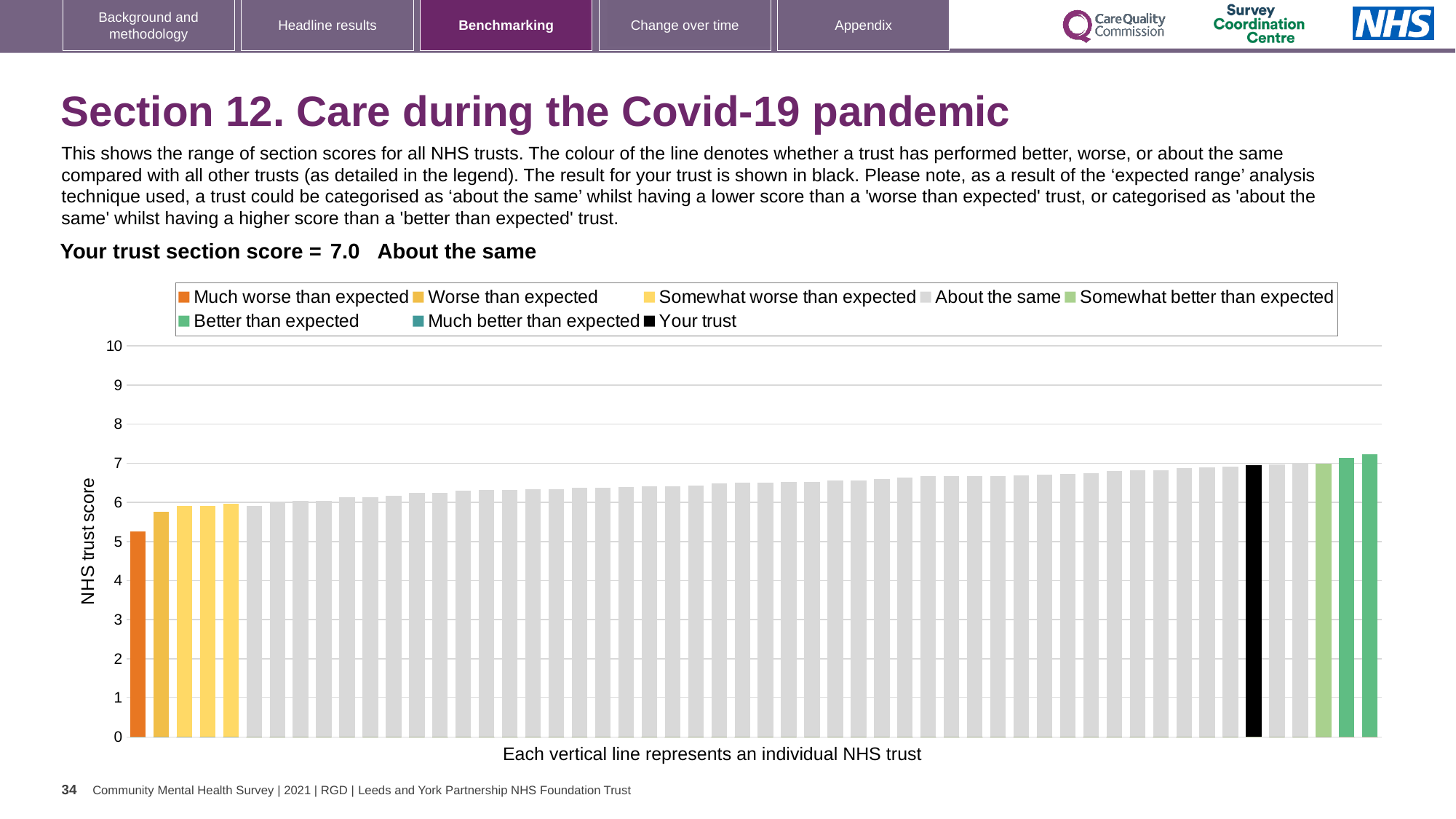
What is the section score for your trust shown on the slide? 7.0 What is the label on the vertical axis of the chart? NHS trust score Which legend category does the tallest bar on the chart belong to? Better than expected Is the value of the tallest bar on the chart greater or less than 8? less Is the value for your trust (the black bar) greater or less than 6? greater Which legend category does the shortest bar on the chart belong to? Much worse than expected Which performance category is your trust placed in for this section? About the same How many entries does the chart legend list? 8 Do the bar values rise or fall moving from left to right along the x axis? rise How many bars are coloured orange ('Much worse than expected')? 1 Is the value of the lowest bar (the orange 'Much worse than expected' trust) greater or less than 6? less What kind of chart is shown on the slide? bar chart